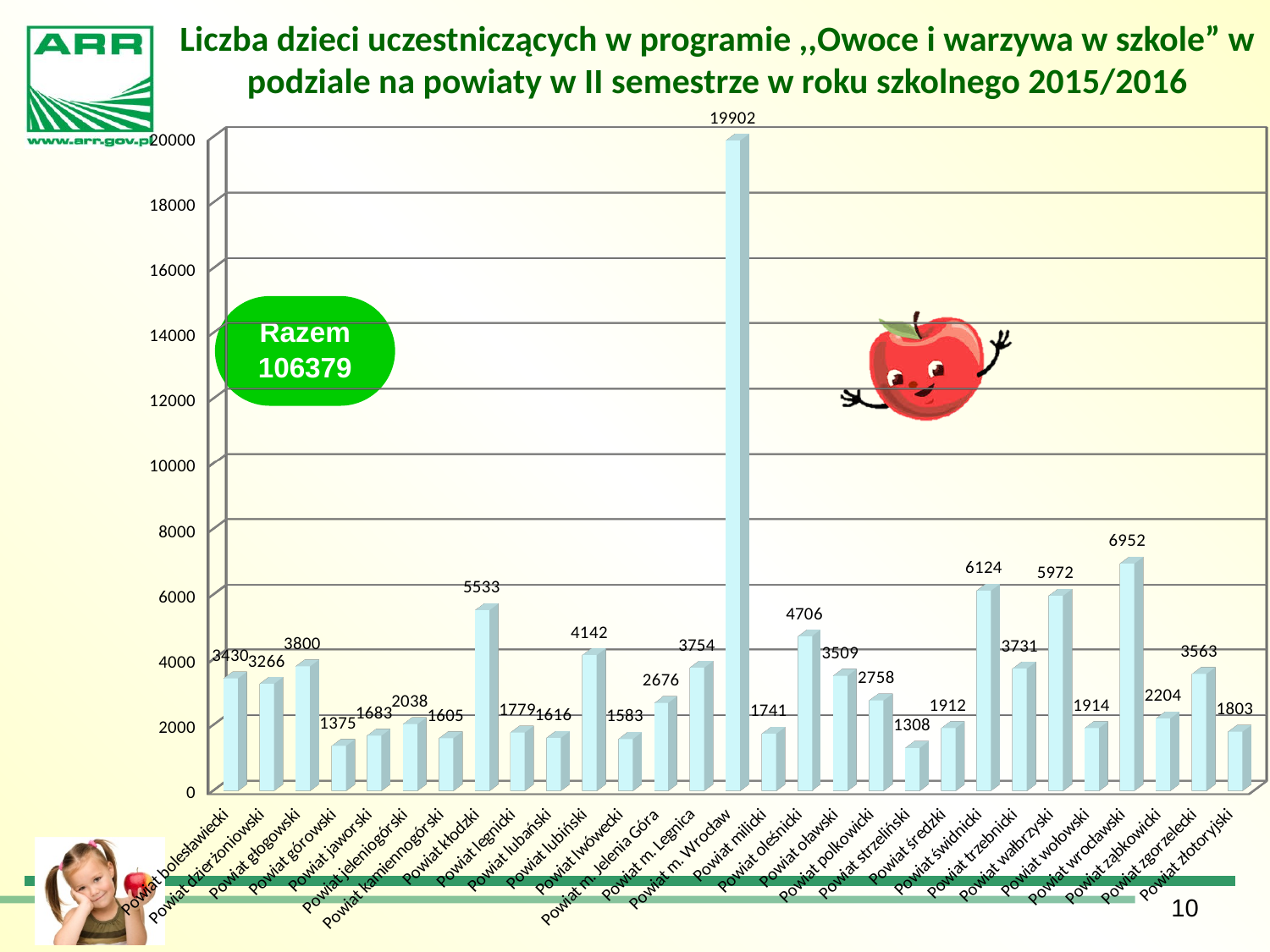
What is the difference between the values for Powiat świdnicki and Powiat wałbrzyski? 152 What is the difference between the values for Powiat m. Wrocław and Powiat wrocławski? 12950 What total (Razem) is shown in the green oval on the slide? 106379 What is the value for Powiat wrocławski? 6952 What is the value for Powiat górowski? 1375 Which is larger, the value for Powiat oleśnicki or Powiat lubiński? Powiat oleśnicki What is the value for Powiat m. Legnica? 3754 How many powiats are shown on the chart? 29 Which powiat has the highest number of children? Powiat m. Wrocław What kind of chart is shown on the slide? Bar chart Which powiat has the lowest number of children? Powiat strzeliński What is the value for Powiat kłodzki? 5533